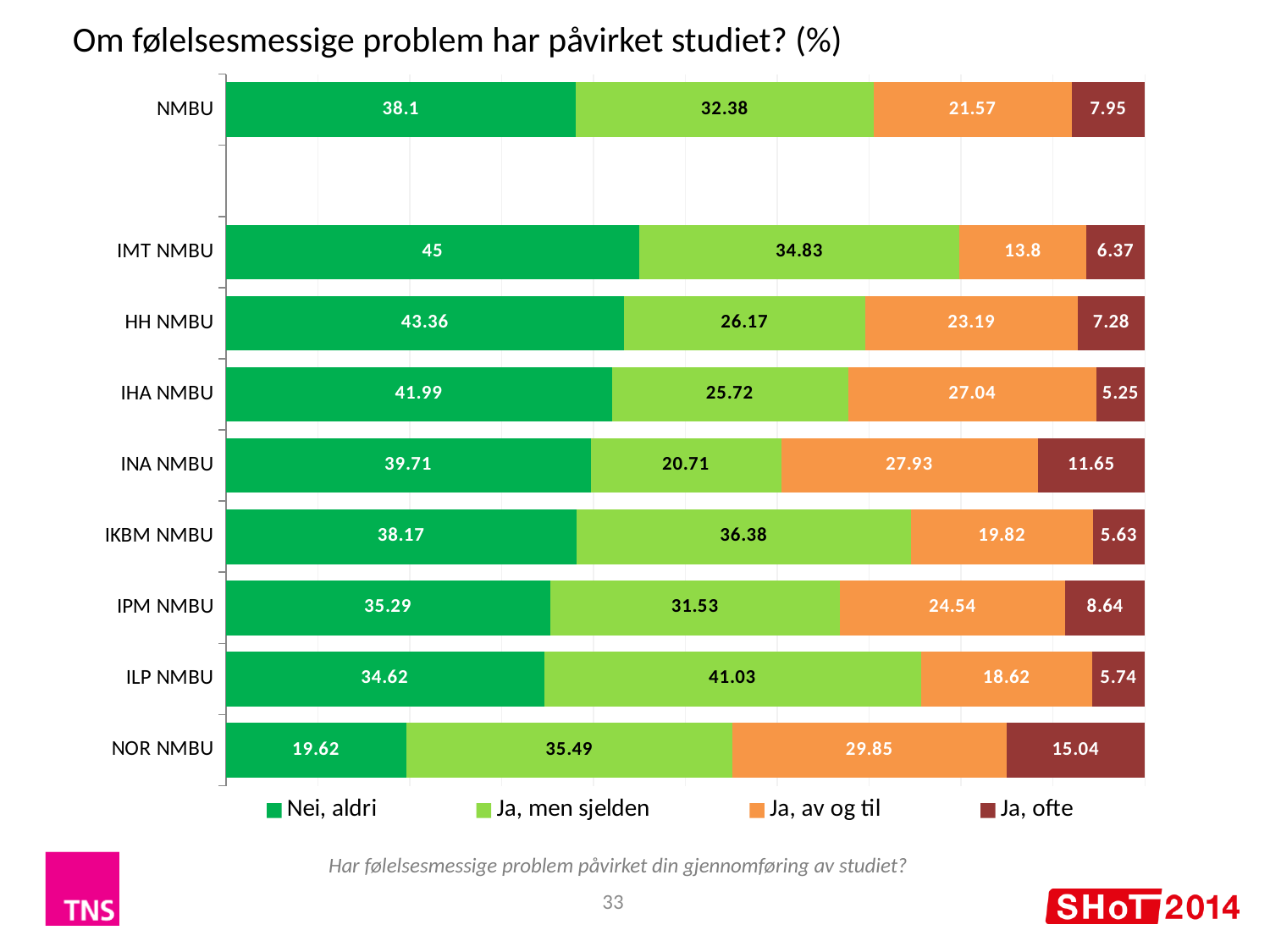
How many categories are shown on the y axis? 9 What is the value of "Ja, ofte" for NOR NMBU? 15.04 Which category has the lowest value for "Nei, aldri"? NOR NMBU What is the value of "Nei, aldri" for IMT NMBU? 45 Which is larger, the "Ja, av og til" value for HH NMBU or for IHA NMBU? IHA NMBU What is the title of the chart? Om følelsesmessige problem har påvirket studiet? (%) How many series does the legend list? 4 Which category has the highest value for "Ja, men sjelden"? ILP NMBU Which category has the highest value for "Nei, aldri"? IMT NMBU What kind of chart is shown on the slide? Stacked bar chart What is the value of "Ja, av og til" for INA NMBU? 27.93 What is the difference between the "Nei, aldri" values for NMBU and NOR NMBU? 18.48